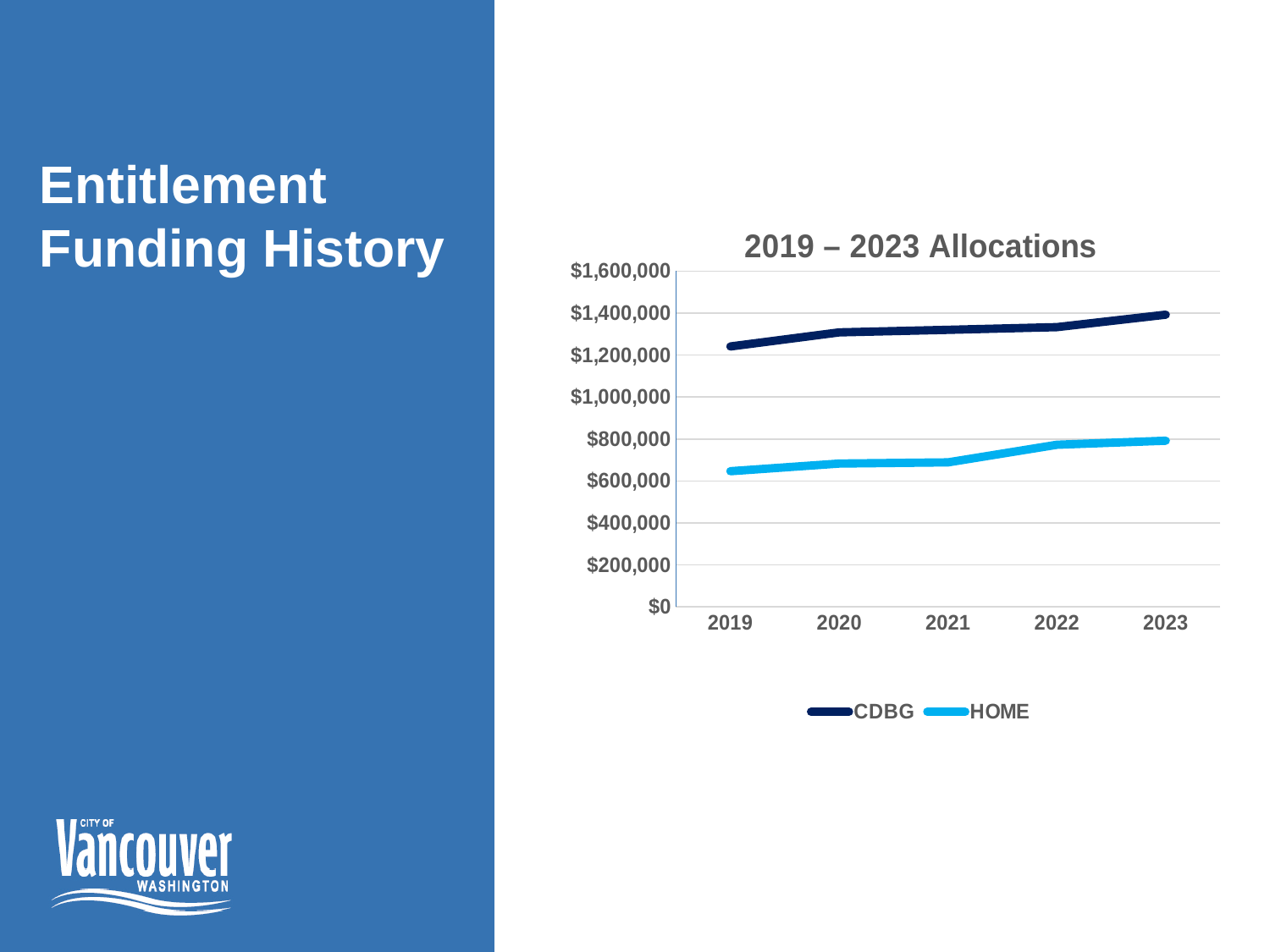
Which series has the larger value in 2022, CDBG or HOME? CDBG What is the title of the chart? 2019 – 2023 Allocations Is the HOME value for 2019 greater or less than $600,000? greater In which year is the CDBG allocation highest? 2023 Is the CDBG value for 2020 greater or less than $1,400,000? less In which year is the HOME allocation lowest? 2019 What kind of chart is shown on the slide? Line chart Which two series are listed in the legend? CDBG and HOME Is the HOME value for 2021 greater or less than $800,000? less How many series does the legend list? 2 How many years are plotted along the x axis? 5